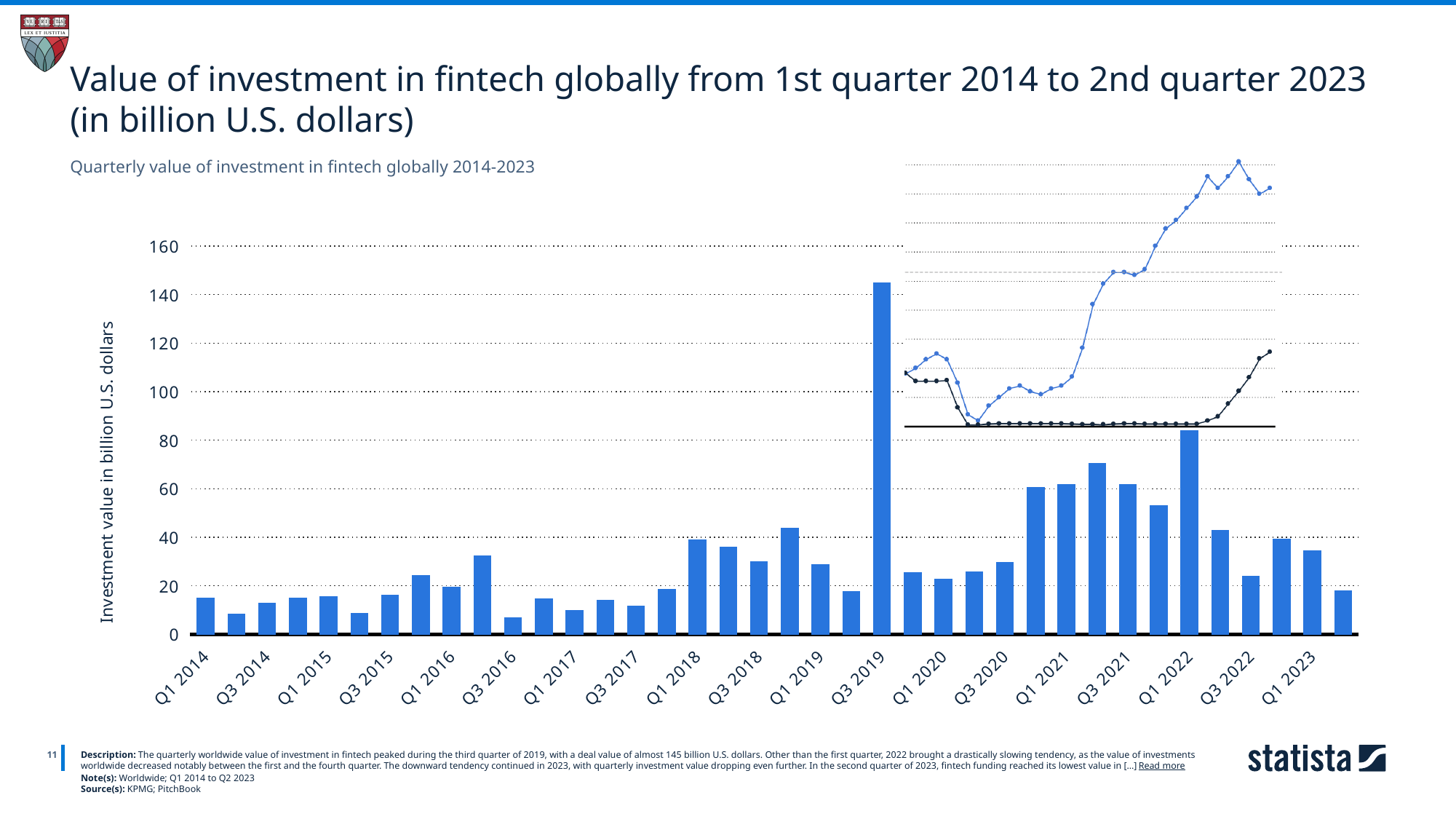
Is the value for Q3 2016 greater or less than 20? less How many quarterly bars are plotted in the chart? 38 Is the value for Q3 2019 greater or less than 140? greater Between Q1 2020 and Q1 2022, do the investment values generally rise or fall? rise What kind of chart is shown on the slide? bar chart Is the value for Q1 2019 greater or less than 40? less Which is larger, the value for Q3 2019 or the value for Q1 2022? Q3 2019 Which quarter has the highest investment value in the bar chart? Q3 2019 What is the label on the vertical axis of the chart? Investment value in billion U.S. dollars Which is larger, the value for Q1 2021 or the value for Q1 2020? Q1 2021